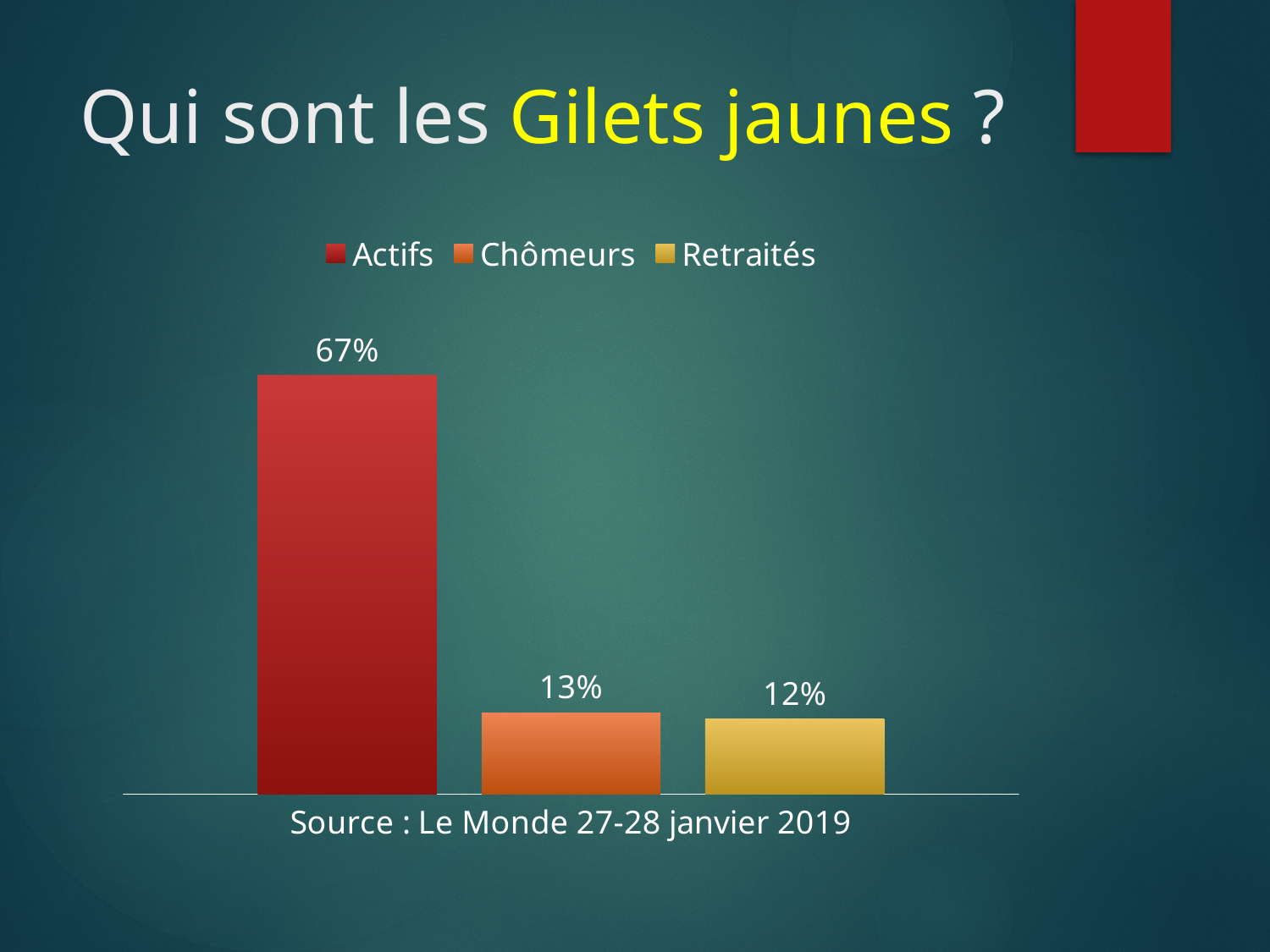
Which category has the lowest value? Retraités Which is larger, the value for Actifs or the value for Retraités? Actifs How many categories are shown in the chart? 3 What is the value for Chômeurs? 13% What is the value for Retraités? 12% What source is cited below the chart? Le Monde 27-28 janvier 2019 What is the difference between the values for Chômeurs and Retraités? 1% Which category has the highest value? Actifs What is the difference between the values for Actifs and Chômeurs? 54% What kind of chart is shown on the slide? Bar chart How many entries does the legend list? 3 What is the value for Actifs? 67%